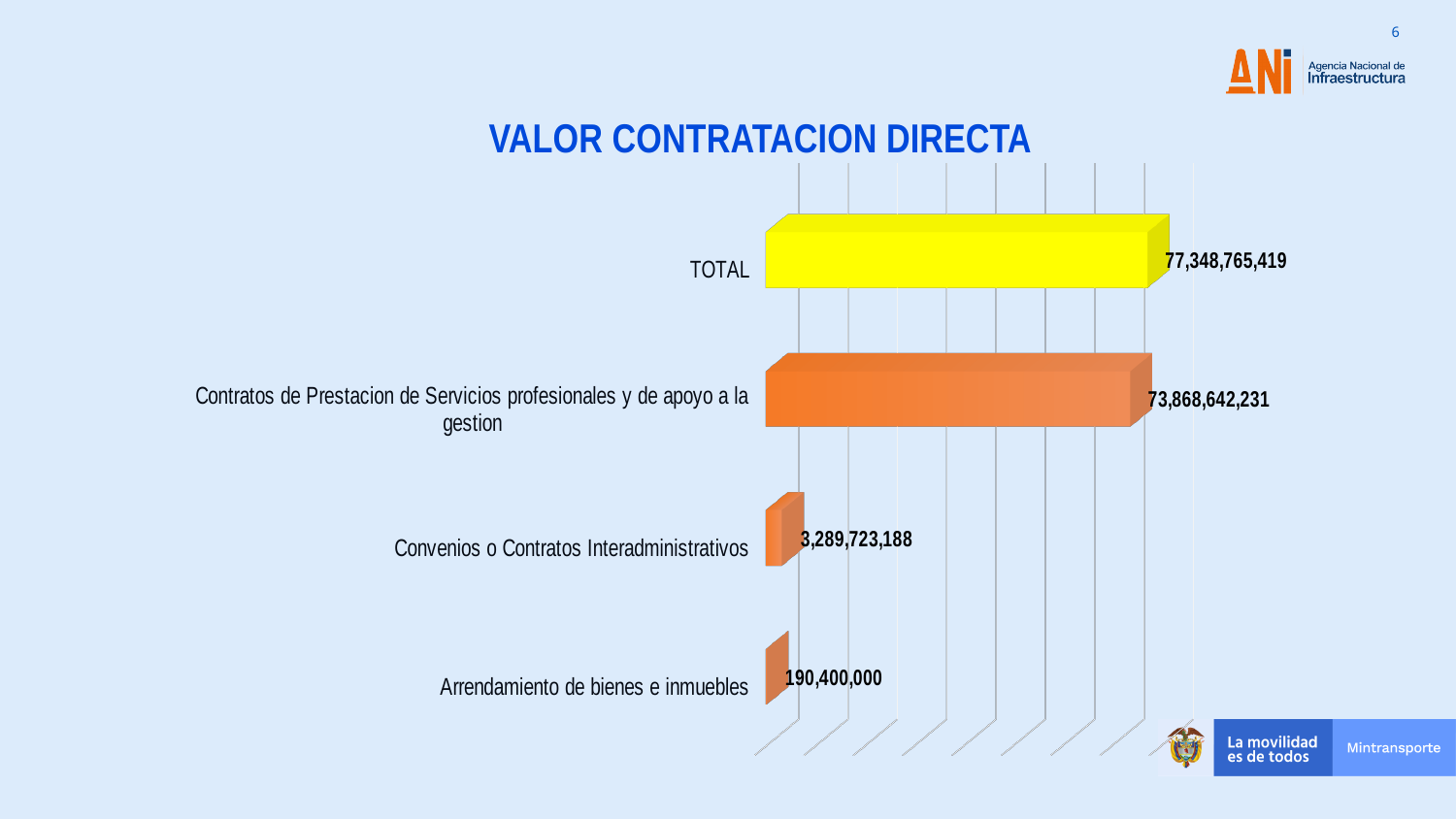
What is the value shown for TOTAL? 77,348,765,419 Which is larger: Convenios o Contratos Interadministrativos or Arrendamiento de bienes e inmuebles? Convenios o Contratos Interadministrativos What is the value for Contratos de Prestacion de Servicios profesionales y de apoyo a la gestion? 73,868,642,231 Excluding the TOTAL bar, which category has the highest value? Contratos de Prestacion de Servicios profesionales y de apoyo a la gestion What is the difference between the TOTAL value and the value for Contratos de Prestacion de Servicios profesionales y de apoyo a la gestion? 3,480,123,188 Which category has the lowest value? Arrendamiento de bienes e inmuebles What is the difference between Convenios o Contratos Interadministrativos and Arrendamiento de bienes e inmuebles? 3,099,323,188 What is the value for Convenios o Contratos Interadministrativos? 3,289,723,188 How many bars are shown in the chart? 4 What type of chart is shown on the slide? Bar chart What is the value for Arrendamiento de bienes e inmuebles? 190,400,000 What is the title of the chart? VALOR CONTRATACION DIRECTA